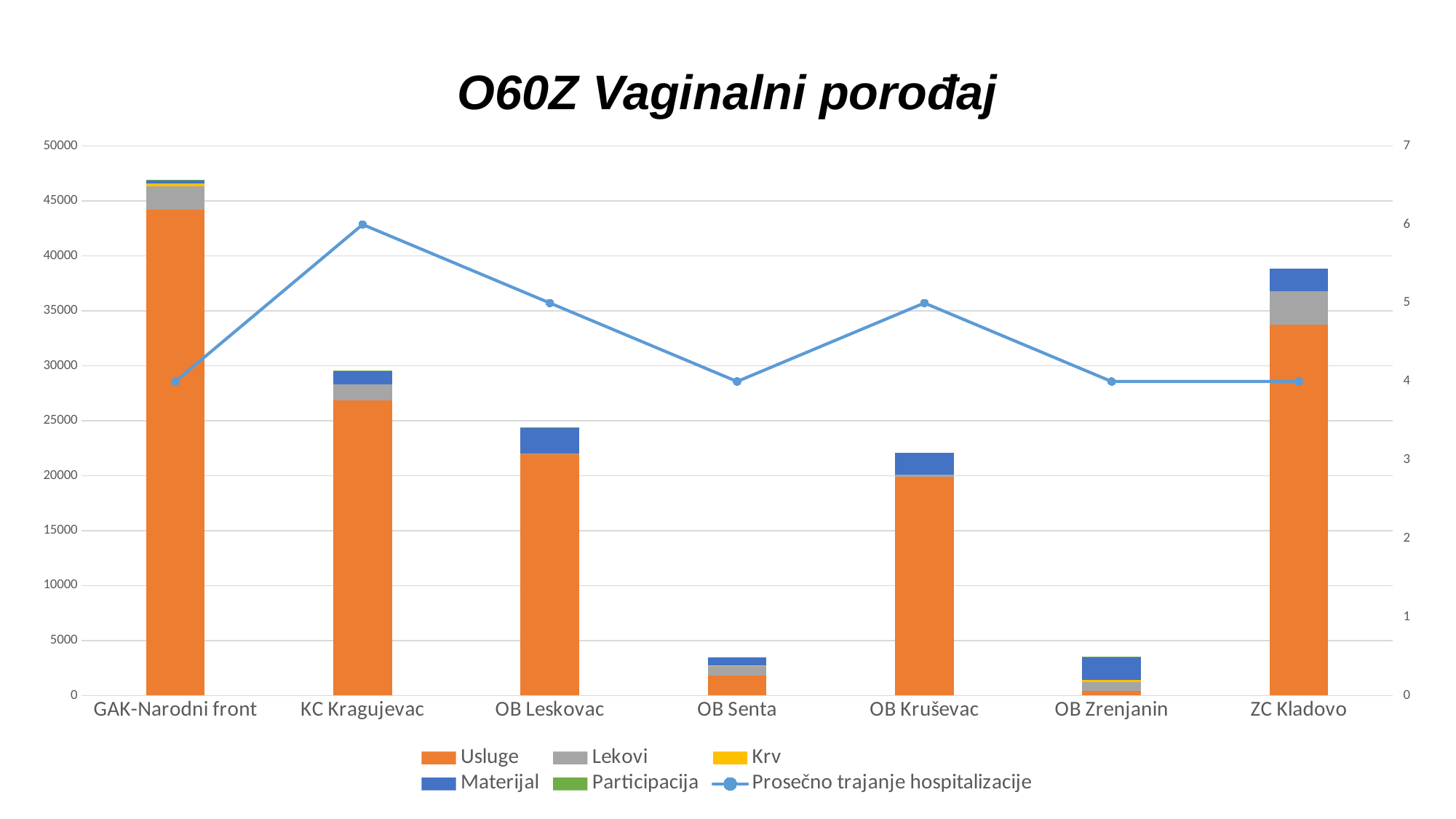
What is the value of Prosečno trajanje hospitalizacije for OB Zrenjanin? 4 What is the title of the chart? O60Z Vaginalni porođaj What type of chart is shown on the slide? Stacked bar chart with a line Which has the larger total stacked bar, ZC Kladovo or OB Kruševac? ZC Kladovo What is the value of Prosečno trajanje hospitalizacije for KC Kragujevac? 6 What is the value of Prosečno trajanje hospitalizacije for OB Leskovac? 5 Is the total stacked bar for OB Senta greater or less than 5000? less How many hospitals (categories) are shown on the x axis? 7 Is the total stacked bar for GAK-Narodni front greater or less than 45000? greater How many series does the legend list? 6 Which hospital has the highest value for Prosečno trajanje hospitalizacije? KC Kragujevac Which hospital has the highest total stacked bar? GAK-Narodni front